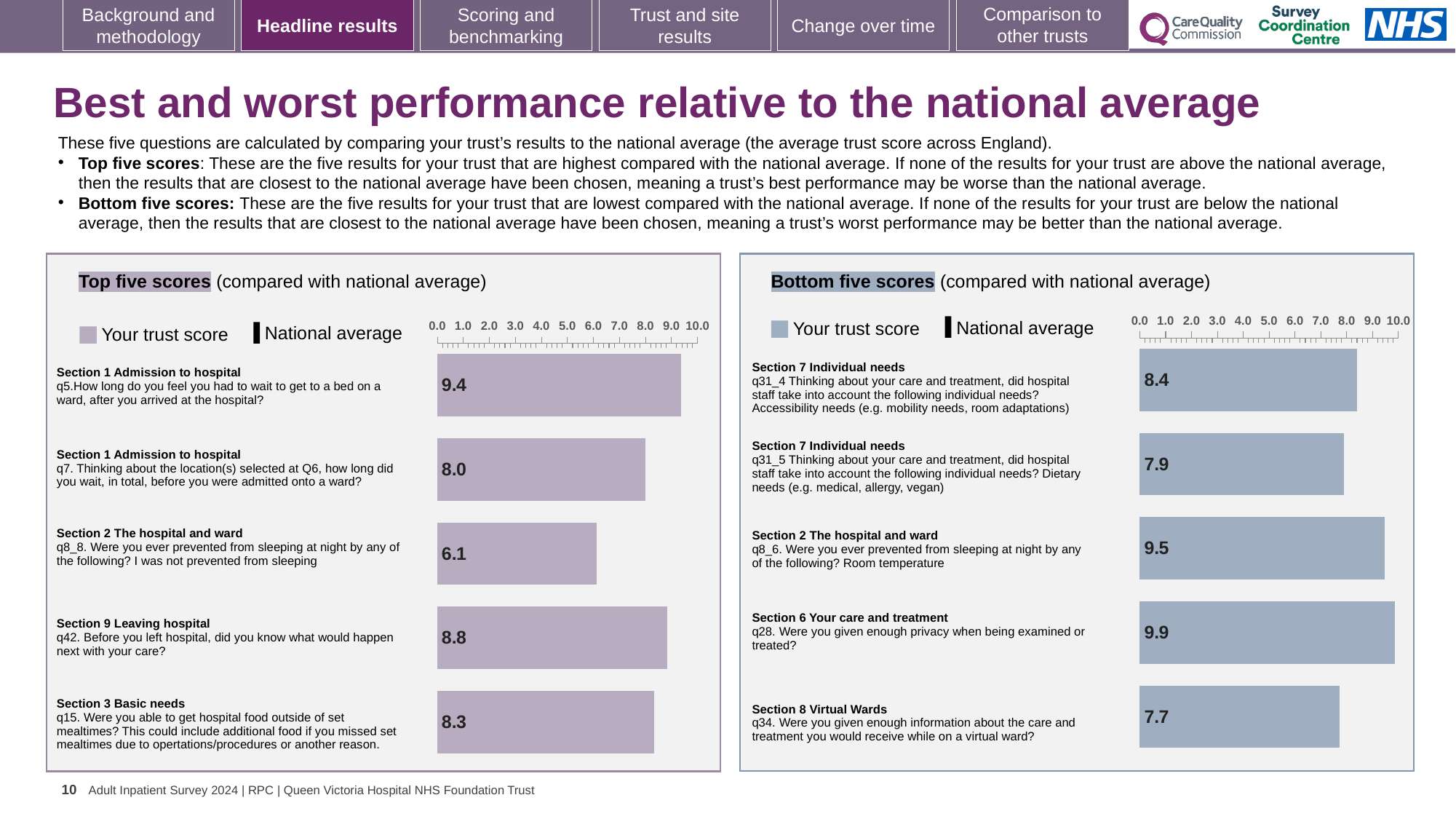
In the Top five scores chart, which question has the lowest trust score? q8_8. Were you ever prevented from sleeping at night by any of the following? I was not prevented from sleeping What kind of chart is used in the Top five scores panel? Bar chart In the Bottom five scores chart, what is the trust score for q34 (information about care and treatment on a virtual ward)? 7.7 In the Bottom five scores chart, what is the difference between the trust scores for q8_6 (room temperature) and q34 (virtual ward)? 1.8 In the Top five scores chart, what is the trust score for q5 (how long you had to wait to get to a bed on a ward)? 9.4 In the Bottom five scores chart, what is the trust score for q28 (enough privacy when being examined or treated)? 9.9 In the Top five scores chart, what is the trust score for q8_8 (I was not prevented from sleeping)? 6.1 How many entries does the legend of the Bottom five scores chart list? 2 In the Top five scores chart, what is the difference between the trust scores for q5 and q7? 1.4 In the Top five scores chart, how many questions are plotted? 5 In the Bottom five scores chart, which question has the highest trust score? q28. Were you given enough privacy when being examined or treated? In the Bottom five scores chart, which is larger: the trust score for q31_4 (accessibility needs) or q31_5 (dietary needs)? q31_4 (accessibility needs)